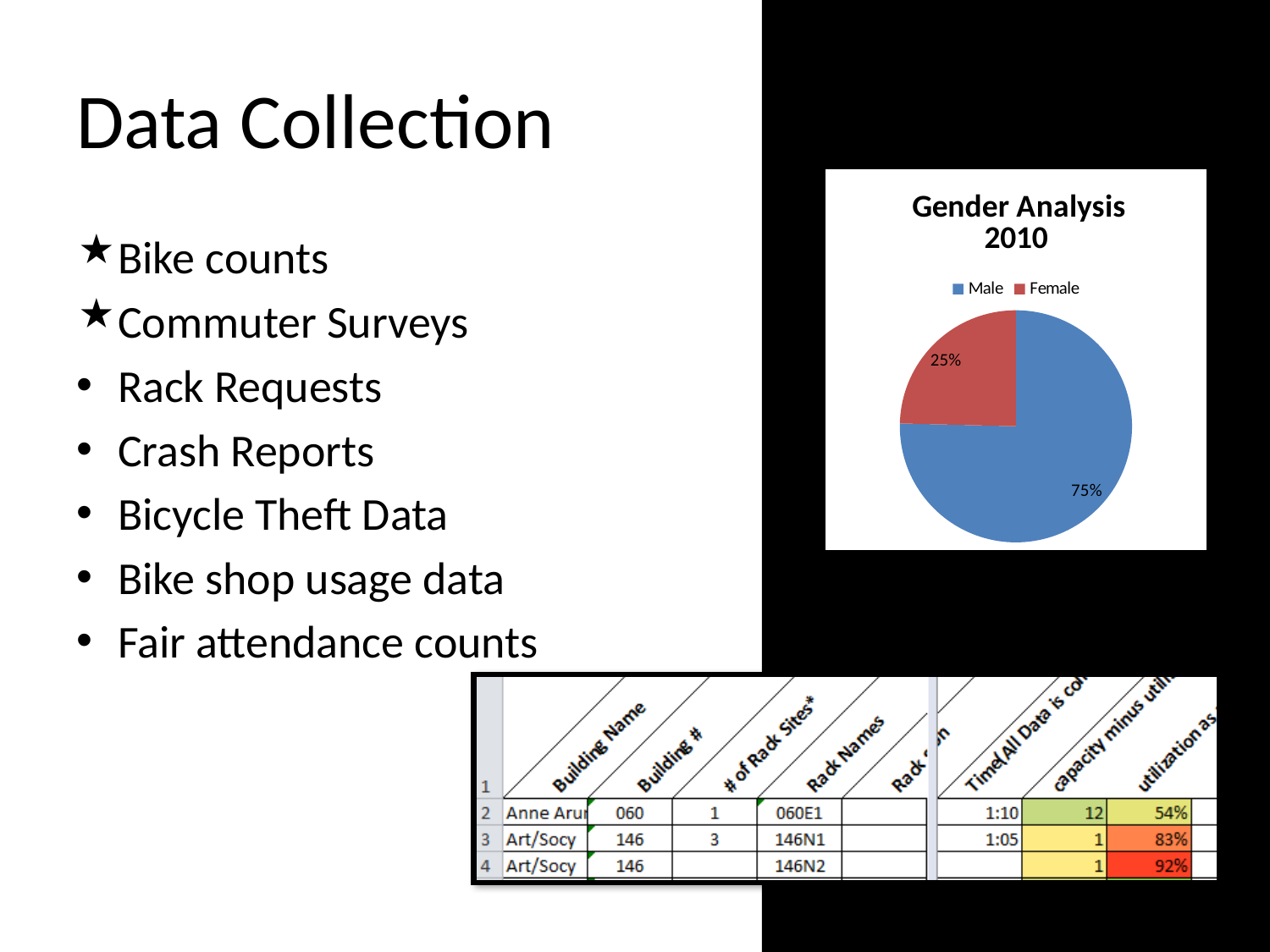
In the Gender Analysis 2010 chart, which is larger, the Male slice or the Female slice? Male How many entries does the legend of the Gender Analysis 2010 chart list? 2 How many slices does the Gender Analysis 2010 pie chart have? 2 In the Gender Analysis 2010 chart, which category has the largest slice? Male In the Gender Analysis 2010 chart, what share of the pie is Female? 25% What is the title of the pie chart on the slide? Gender Analysis 2010 In the Gender Analysis 2010 chart, what colour is the Female slice? red In the Gender Analysis 2010 chart, what is the difference in percentage points between the Male and Female slices? 50 percentage points In the Gender Analysis 2010 chart, which category has the smallest slice? Female What type of chart is the Gender Analysis 2010 chart? pie chart In the Gender Analysis 2010 chart, what share of the pie is Male? 75%